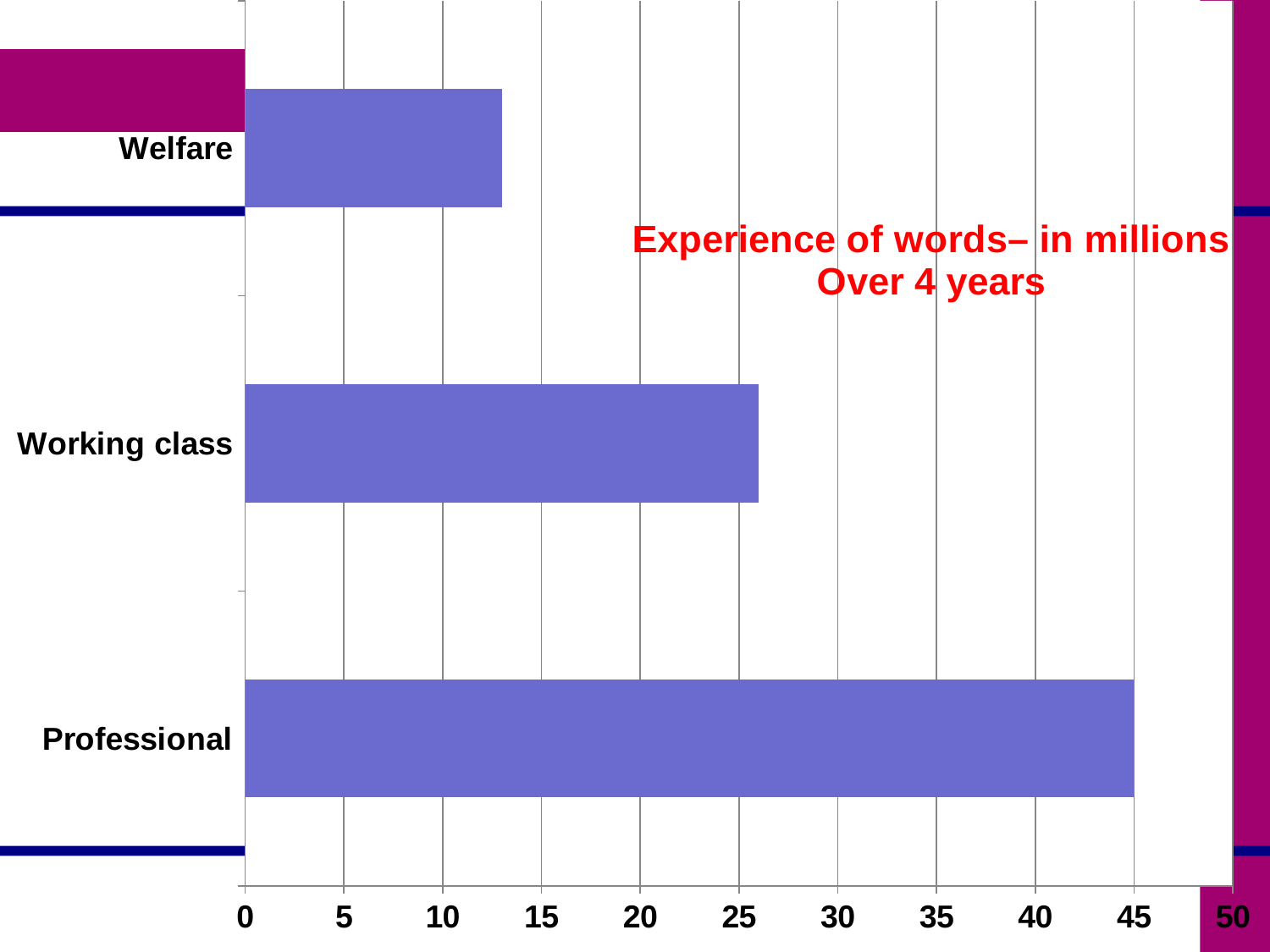
Which is larger, the value for Working class or the value for Welfare? Working class Is the value for Welfare greater or less than 10? greater Is the value for Welfare greater or less than 15? less How many categories are plotted in the chart? 3 What is the value for Professional? 45 Which category has the lowest value? Welfare Is the value for Working class greater or less than 25? greater What is the maximum value shown on the horizontal axis? 50 Which category has the highest value? Professional What type of chart is shown on the slide? bar chart What is the title text shown in red on the chart? Experience of words– in millions Over 4 years